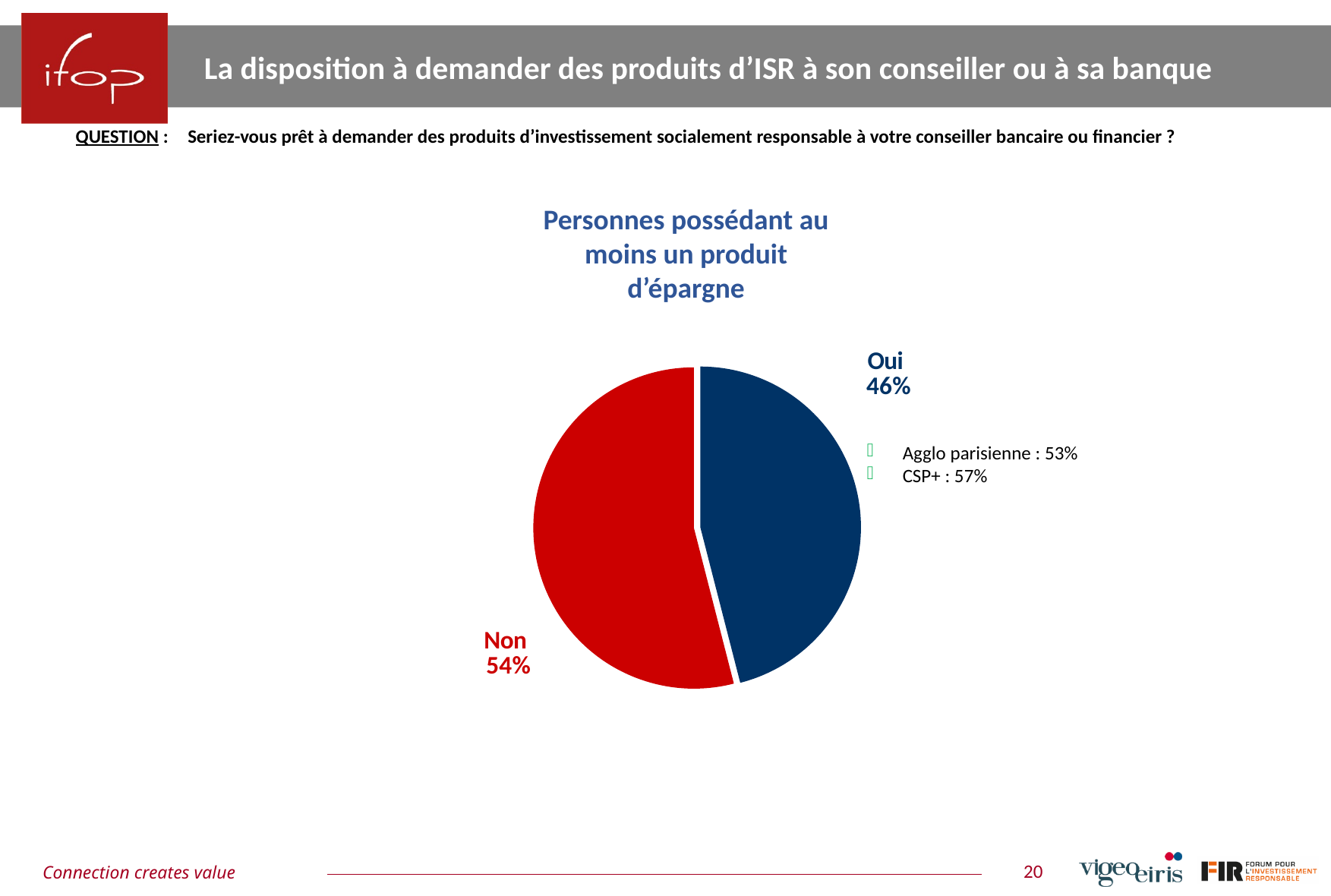
How many slices does the pie chart have? 2 What is the total of the two slices shown in the pie chart? 100% What type of chart is shown on the slide? pie chart What colour is the "Non" slice of the pie chart? red Which slice of the pie chart is the smallest? Oui What is the value for "Oui" in the pie chart? 46% What is the difference between the "Non" and "Oui" shares in the pie chart? 8% What is the title of the pie chart? Personnes possédant au moins un produit d'épargne Which is larger in the pie chart, "Oui" or "Non"? Non What is the value for "Non" in the pie chart? 54% Which slice of the pie chart is the largest? Non Is the value for "Oui" in the pie chart greater or less than 50%? less